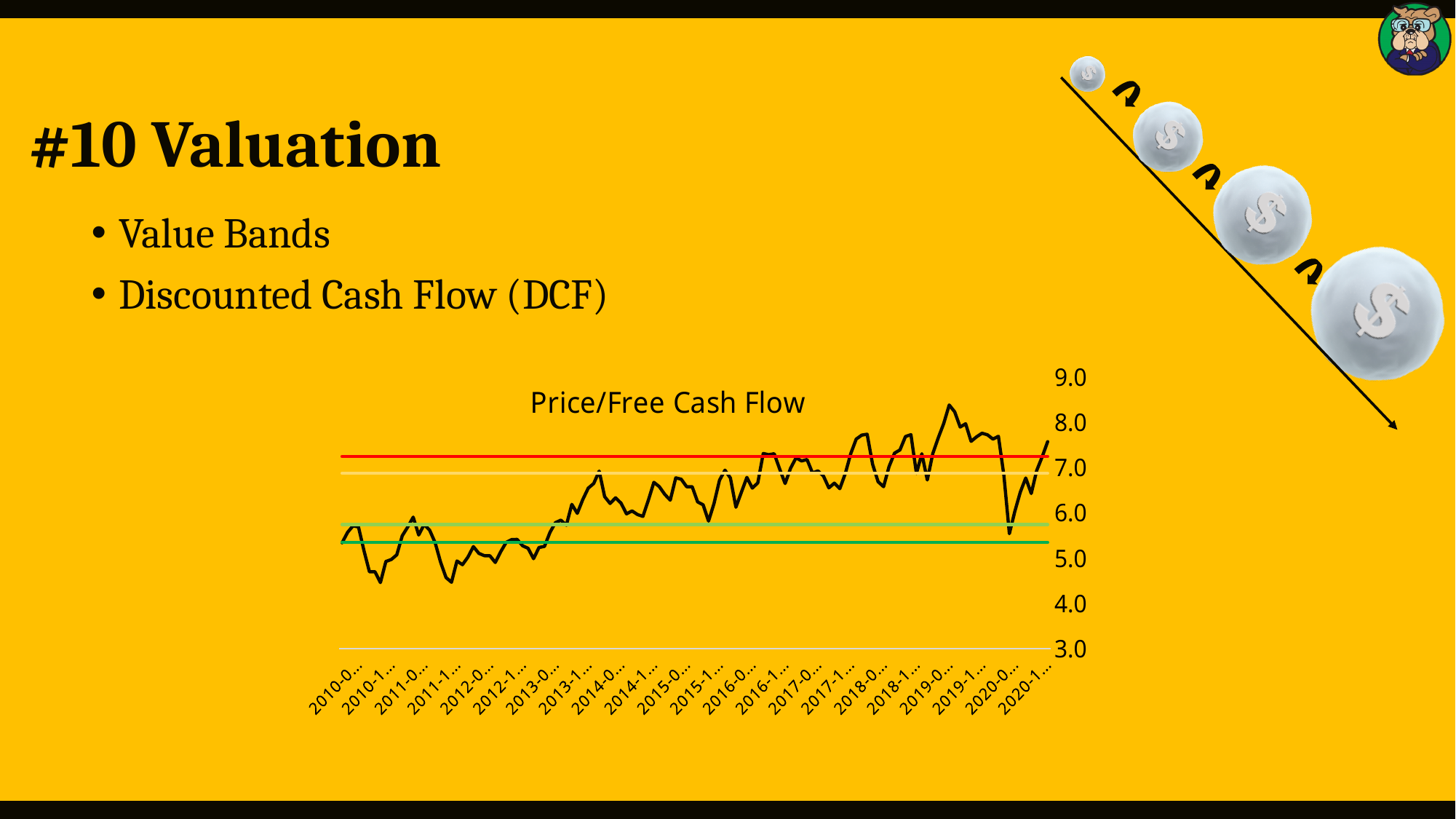
Is the highest point of the Price/Free Cash Flow line greater or less than 8.0? greater Does the Price/Free Cash Flow line generally rise or fall from 2010 to 2020? rise What kind of chart is shown on the slide? line chart Is the Price/Free Cash Flow value at the start of the series in 2010 greater or less than 6.0? less Is the Price/Free Cash Flow value at the end of the series in late 2020 greater or less than 7.0? greater What is the title of the chart? Price/Free Cash Flow What is the highest value shown on the y axis? 9.0 In which year does the Price/Free Cash Flow line reach its highest peak? 2019